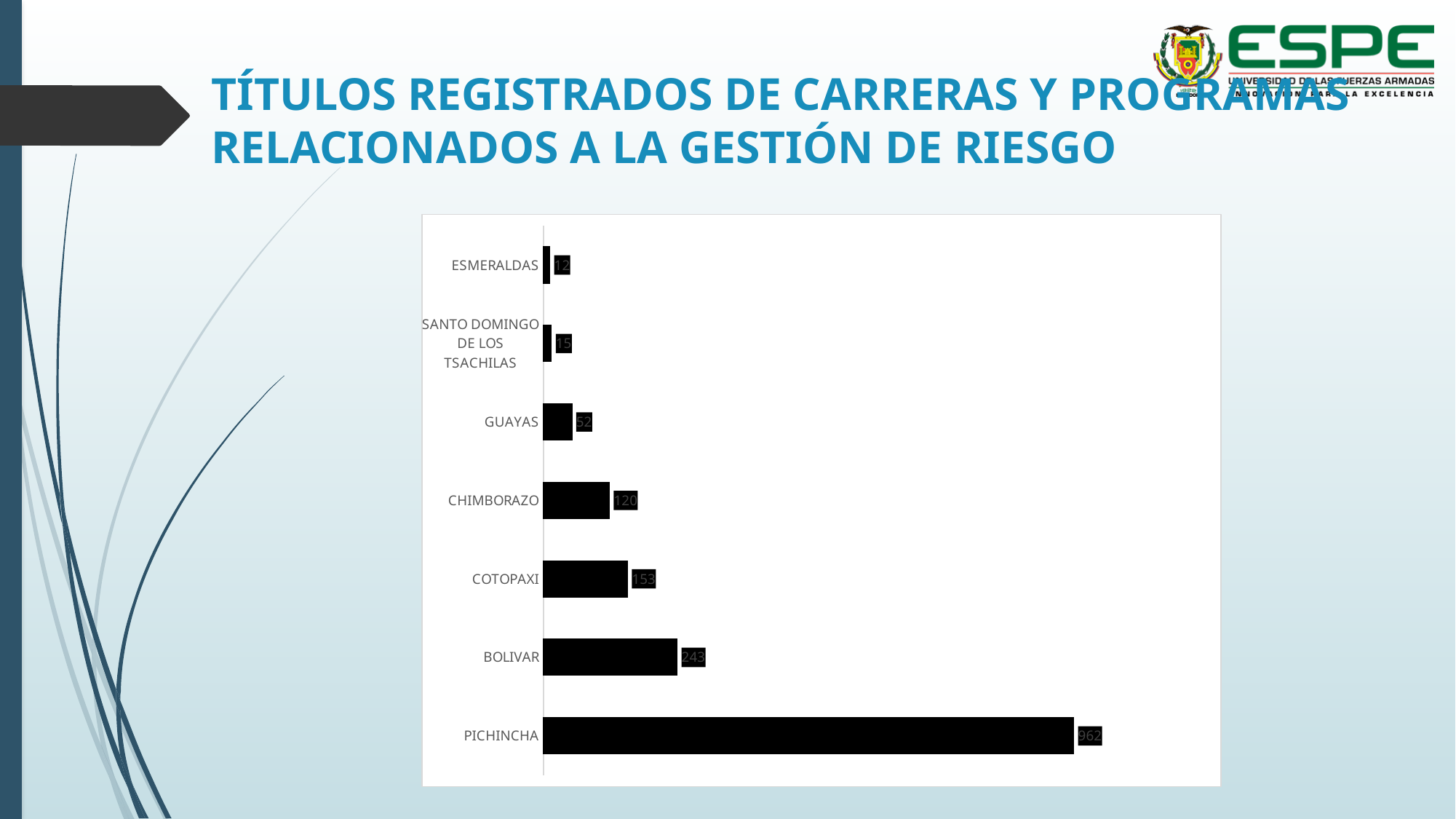
What is the value for PICHINCHA? 962 Which category has the highest value? PICHINCHA Which category has the lowest value? ESMERALDAS What is the value for CHIMBORAZO? 120 What is the value for SANTO DOMINGO DE LOS TSACHILAS? 15 What colour are the bars in the chart? black Which is larger, the value for GUAYAS or the value for COTOPAXI? COTOPAXI How many categories are shown in the chart? 7 What is the difference between the values for COTOPAXI and CHIMBORAZO? 33 What is the difference between the values for PICHINCHA and BOLIVAR? 719 What is the value for BOLIVAR? 243 What kind of chart is shown on the slide? bar chart